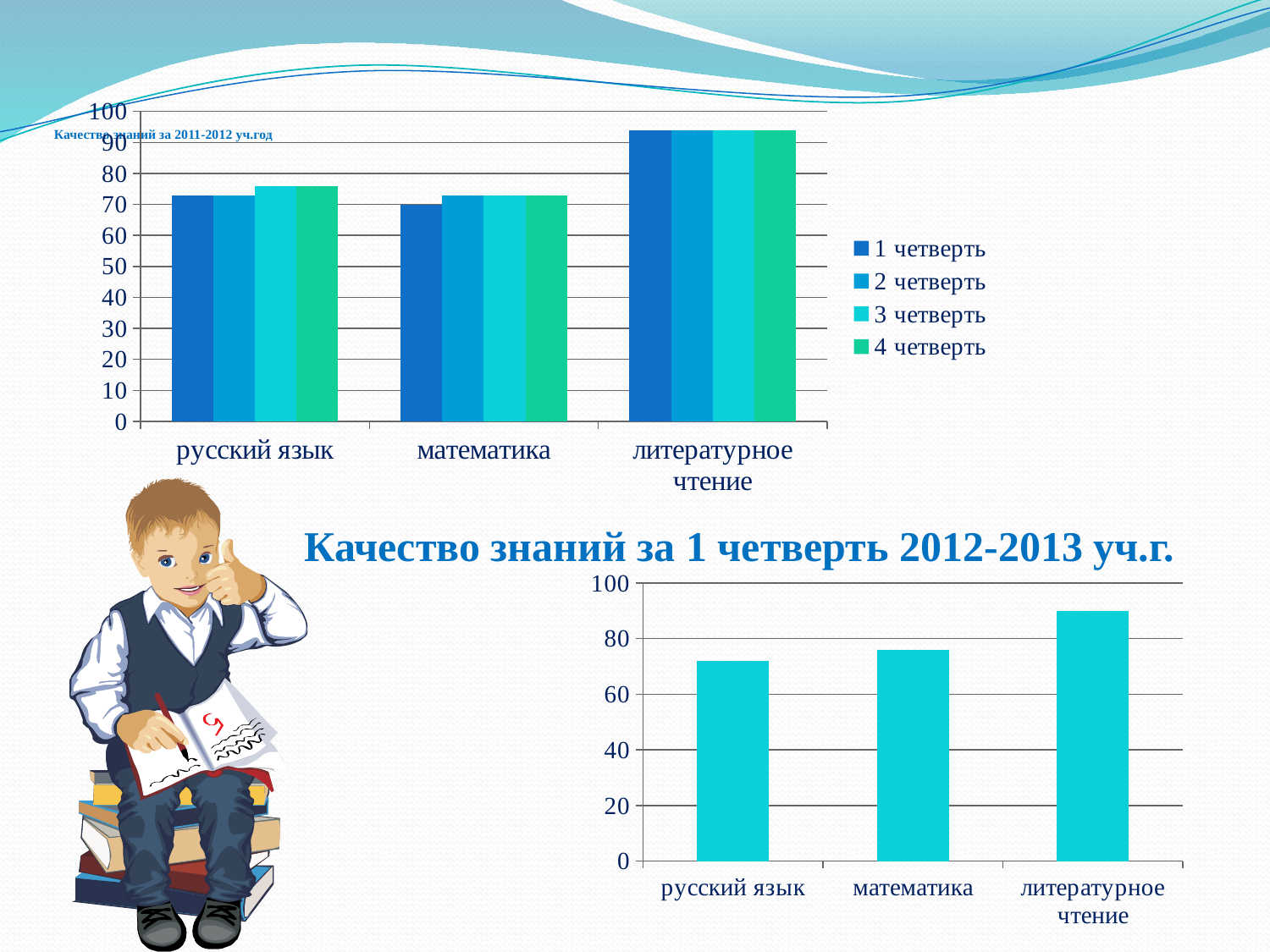
How many series does the legend of the top chart list? 4 In the bottom chart, is the value for литературное чтение greater or less than 80? greater In the bottom chart, which category has the lowest value? русский язык In the bottom chart, which category has the highest value? литературное чтение What kind of chart is the top chart (Качество знаний за 2011-2012 уч.год)? bar chart In the top chart, which is larger for русский язык: 1 четверть or 3 четверть? 3 четверть What kind of chart is the bottom chart (Качество знаний за 1 четверть 2012-2013 уч.г.)? bar chart What is the title of the bottom chart? Качество знаний за 1 четверть 2012-2013 уч.г. In the top chart, is the value for 1 четверть in математика greater or less than 80? less How many categories are shown on the x axis of the bottom chart? 3 In the bottom chart, is the value for русский язык greater or less than 80? less In the top chart, which category has the highest values across all quarters? литературное чтение